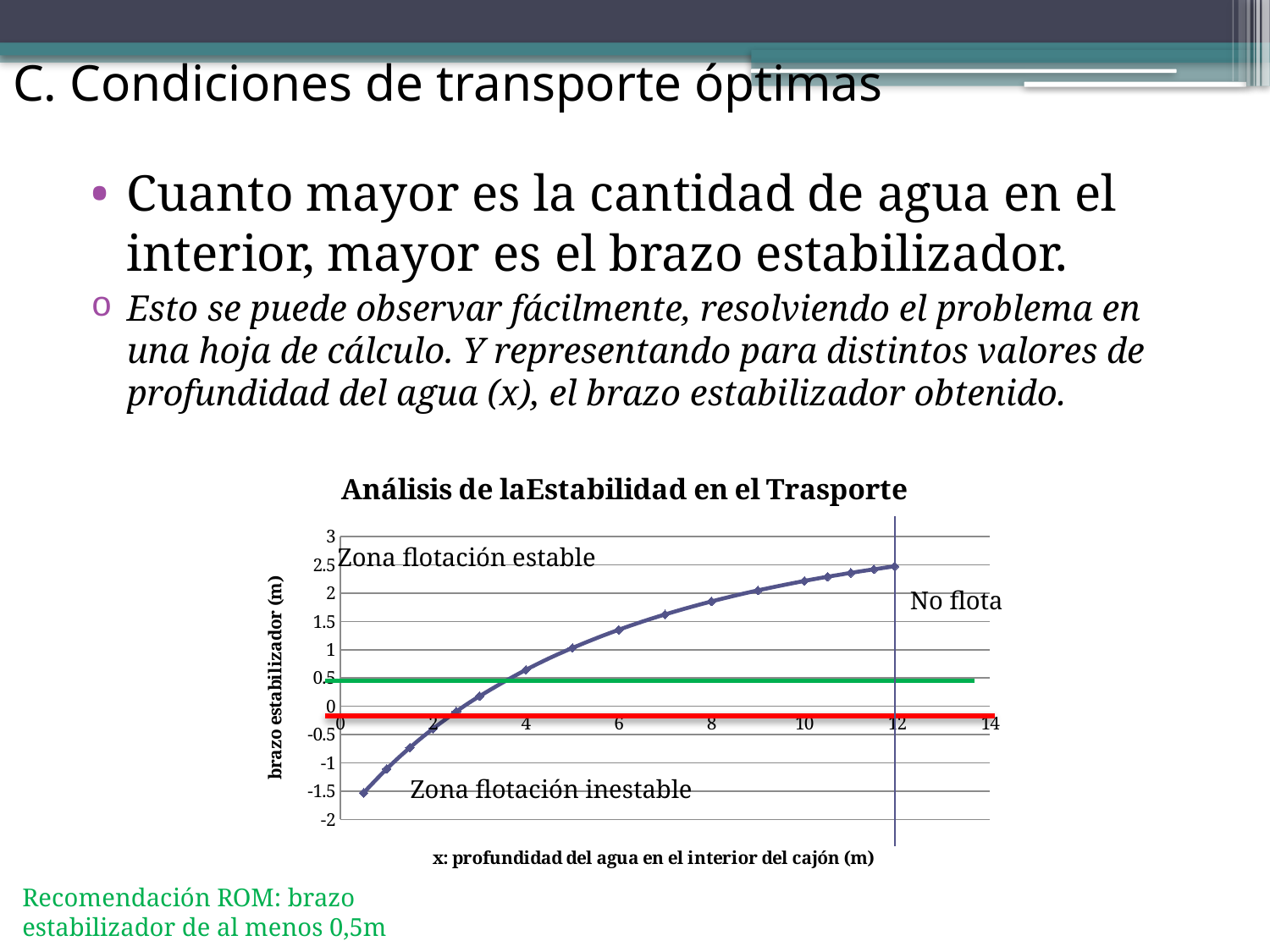
Is the lowest plotted value of brazo estabilizador greater or less than -1? less What kind of chart is shown on the slide? line chart Do the plotted values rise or fall as x increases along the x axis? rise Is the value of brazo estabilizador at x = 1 greater or less than 0? less What is the label of the x axis of the chart? x: profundidad del agua en el interior del cajón (m) Is the value of brazo estabilizador at x = 10 greater or less than 2? greater What is the title of the chart? Análisis de laEstabilidad en el Trasporte Which is larger, the brazo estabilizador at x = 10 or at x = 4? x = 10